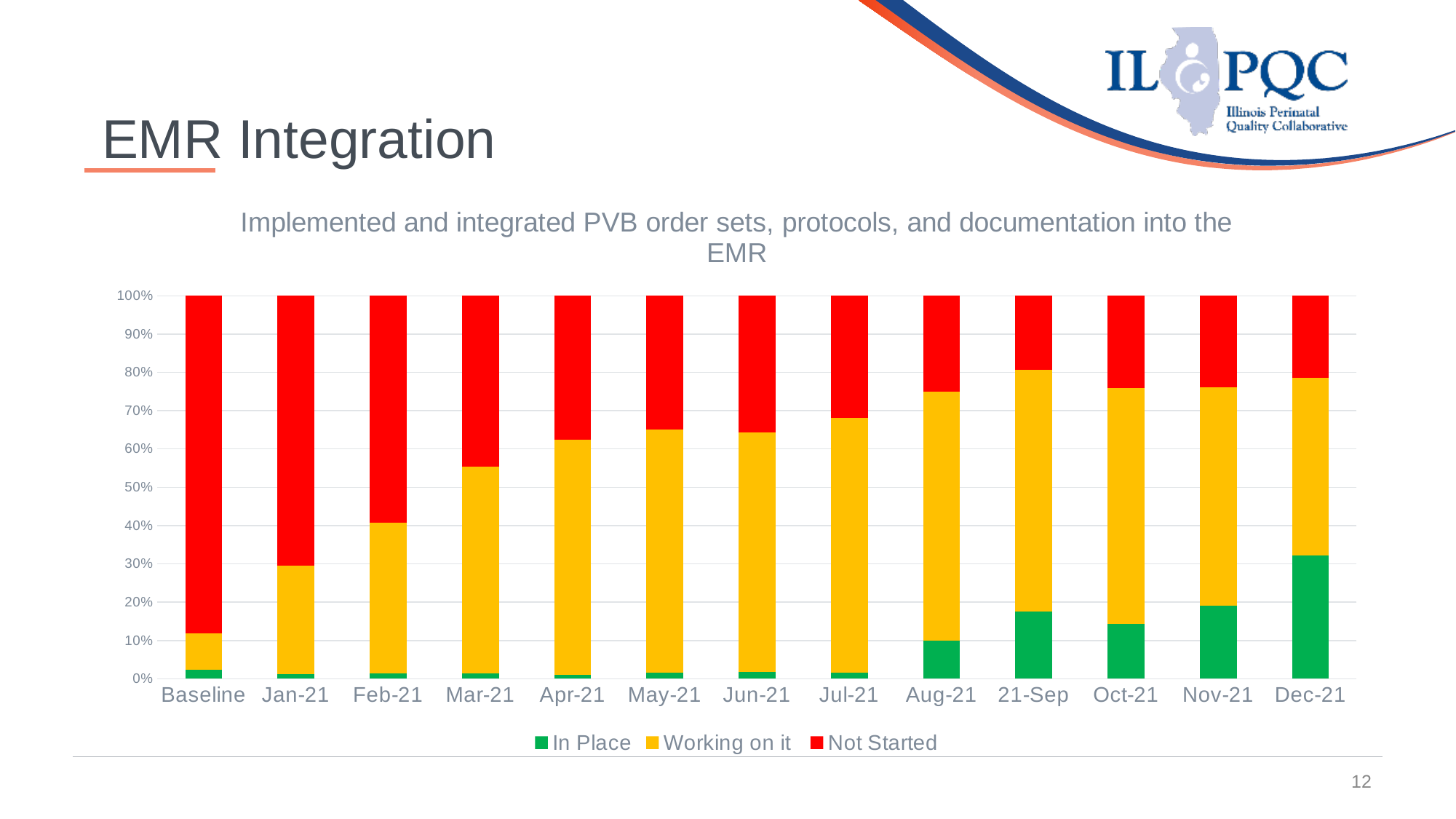
What is the title of the chart? Implemented and integrated PVB order sets, protocols, and documentation into the EMR Which has the larger 'In Place' share, Oct-21 or Nov-21? Nov-21 Is the 'In Place' share for Jan-21 greater or less than 10%? less How many categories are shown along the x axis? 13 Is the 'In Place' share for Dec-21 greater or less than 20%? greater What kind of chart is shown on the slide? Stacked bar chart Does the 'Not Started' share generally rise or fall from Baseline to Dec-21? fall How many series does the legend list? 3 Is the 'Not Started' share for Baseline greater or less than 80%? greater Which category has the largest 'In Place' share? Dec-21 Which category has the largest 'Not Started' share? Baseline Which has the larger 'Not Started' share, Baseline or Dec-21? Baseline